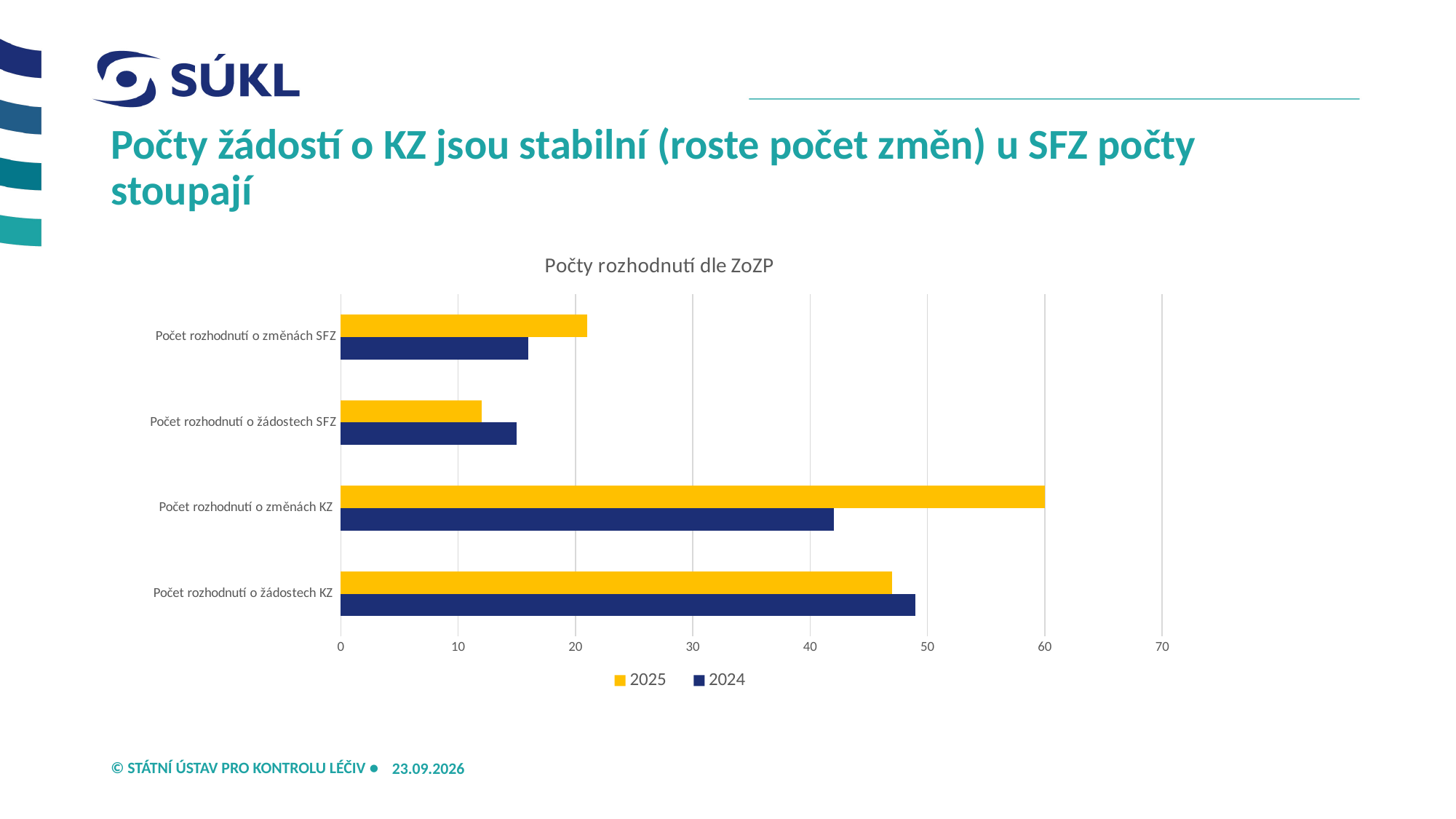
Is the 2024 value for Počet rozhodnutí o změnách KZ greater or less than 40? greater What type of chart is shown on the slide? bar chart How many categories are shown on the chart? 4 For Počet rozhodnutí o změnách SFZ, which series has the larger value, 2025 or 2024? 2025 Is the 2025 value for Počet rozhodnutí o změnách SFZ greater or less than 20? greater Which category has the lowest 2025 value? Počet rozhodnutí o žádostech SFZ Which category has the highest 2025 value? Počet rozhodnutí o změnách KZ What is the title of the chart? Počty rozhodnutí dle ZoZP Which category has the highest 2024 value? Počet rozhodnutí o žádostech KZ For Počet rozhodnutí o žádostech SFZ, which series has the larger value, 2025 or 2024? 2024 How many series does the legend list? 2 What is the 2025 value for Počet rozhodnutí o změnách KZ? 60